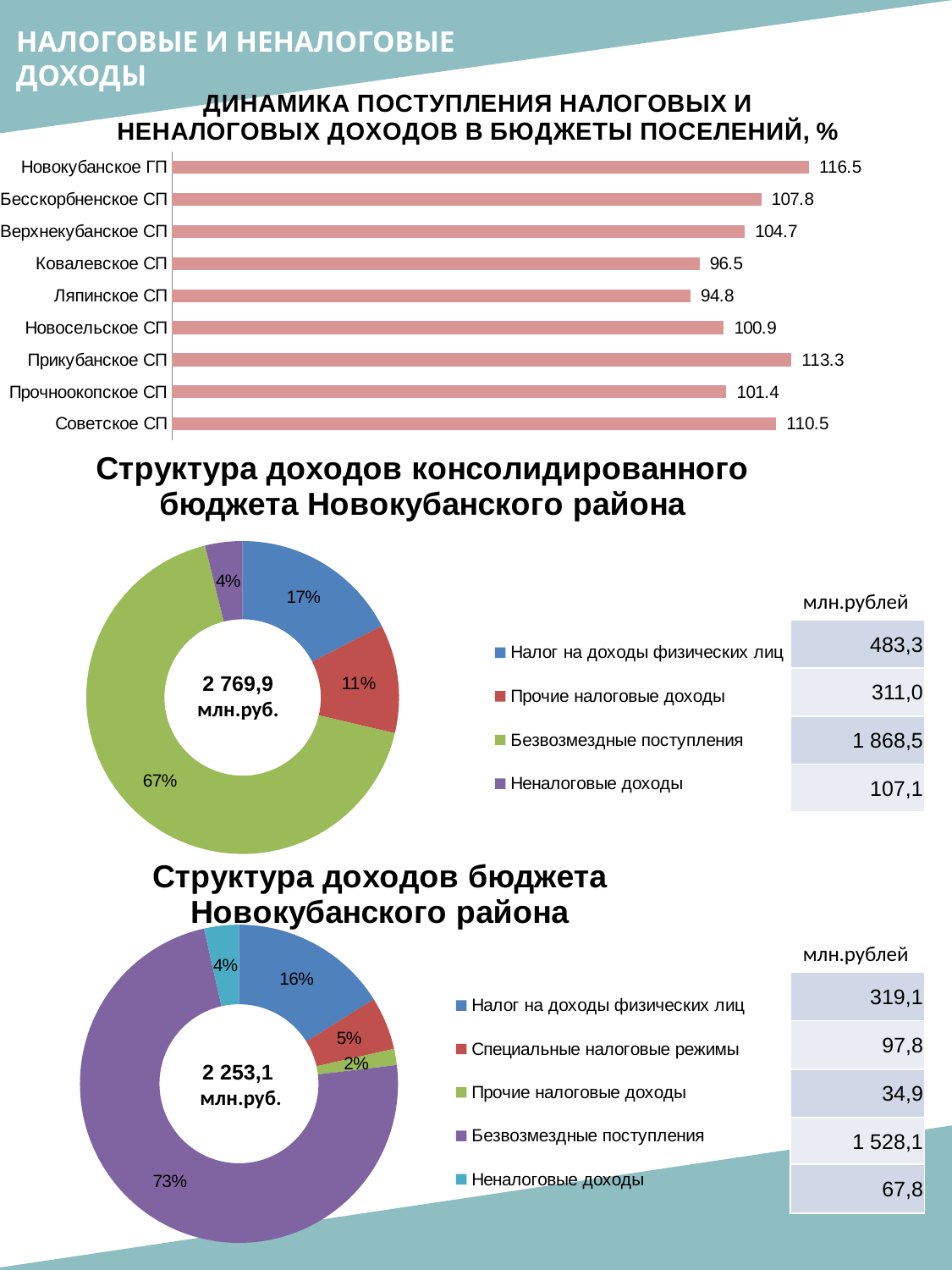
In the bar chart 'Динамика поступления налоговых и неналоговых доходов в бюджеты поселений, %', what is the value for Прикубанское СП? 113.3 In the chart 'Структура доходов консолидированного бюджета Новокубанского района', what share do Безвозмездные поступления make up? 67% In the bar chart 'Динамика поступления налоговых и неналоговых доходов в бюджеты поселений, %', what is the difference between Новокубанское ГП and Советское СП? 6.0 What total in млн.руб. is shown in the centre of the chart 'Структура доходов бюджета Новокубанского района'? 2 253,1 How many categories does the legend list in the chart 'Структура доходов бюджета Новокубанского района'? 5 In the chart 'Структура доходов бюджета Новокубанского района', what share do Специальные налоговые режимы make up? 5% What type of chart is 'Динамика поступления налоговых и неналоговых доходов в бюджеты поселений, %'? Bar chart How many settlements are shown in the bar chart 'Динамика поступления налоговых и неналоговых доходов в бюджеты поселений, %'? 9 In the chart 'Структура доходов консолидированного бюджета Новокубанского района', what is the value in млн.рублей for Налог на доходы физических лиц? 483,3 In the bar chart 'Динамика поступления налоговых и неналоговых доходов в бюджеты поселений, %', which is larger: Бесскорбненское СП or Верхнекубанское СП? Бесскорбненское СП In the bar chart 'Динамика поступления налоговых и неналоговых доходов в бюджеты поселений, %', which settlement has the highest value? Новокубанское ГП In the bar chart 'Динамика поступления налоговых и неналоговых доходов в бюджеты поселений, %', which settlement has the lowest value? Ляпинское СП